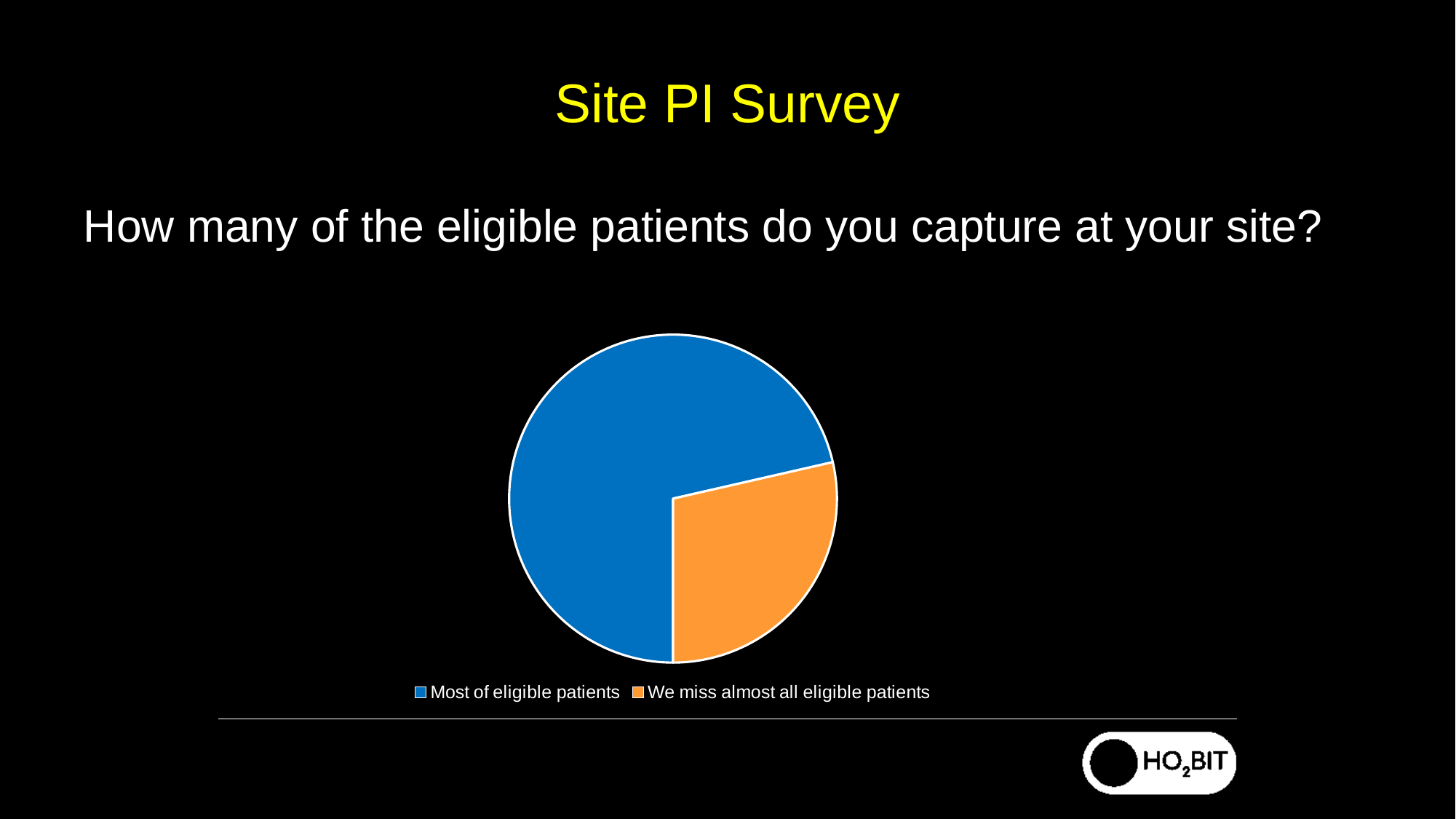
Which category has the largest slice of the pie chart? Most of eligible patients What question does the pie chart on the slide answer? How many of the eligible patients do you capture at your site? What kind of chart is shown on the slide? pie chart Which slice is larger: "Most of eligible patients" or "We miss almost all eligible patients"? Most of eligible patients How many slices does the pie chart have? 2 What colour is the slice for "We miss almost all eligible patients"? orange How many entries does the legend of the pie chart list? 2 Which category has the smallest slice of the pie chart? We miss almost all eligible patients